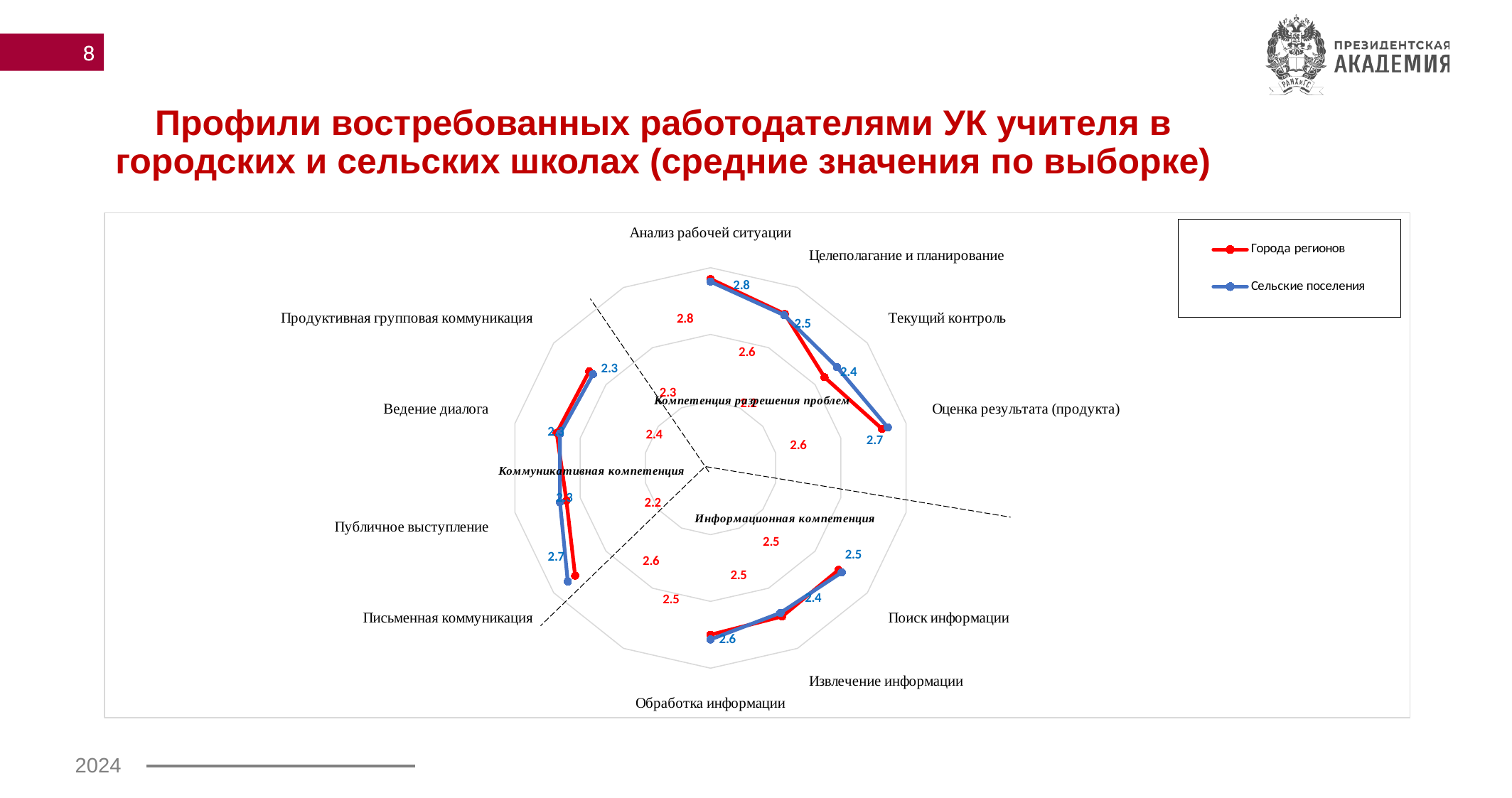
What is the value for Сельские поселения for Текущий контроль? 2.4 How many competency categories are plotted around the radar chart? 11 For the Сельские поселения series, which category has the highest value? Анализ рабочей ситуации What kind of chart is shown on the slide? Radar chart How many series does the legend list? 2 What is the value for Сельские поселения for Обработка информации? 2.6 What is the value for Сельские поселения for Оценка результата (продукта)? 2.7 What is the value for Сельские поселения for Анализ рабочей ситуации? 2.8 What is the value for Сельские поселения for Письменная коммуникация? 2.7 What colour is used for the Города регионов series? Red What is the value for Сельские поселения for Поиск информации? 2.5 For Текущий контроль, which series has the larger value, Города регионов or Сельские поселения? Сельские поселения